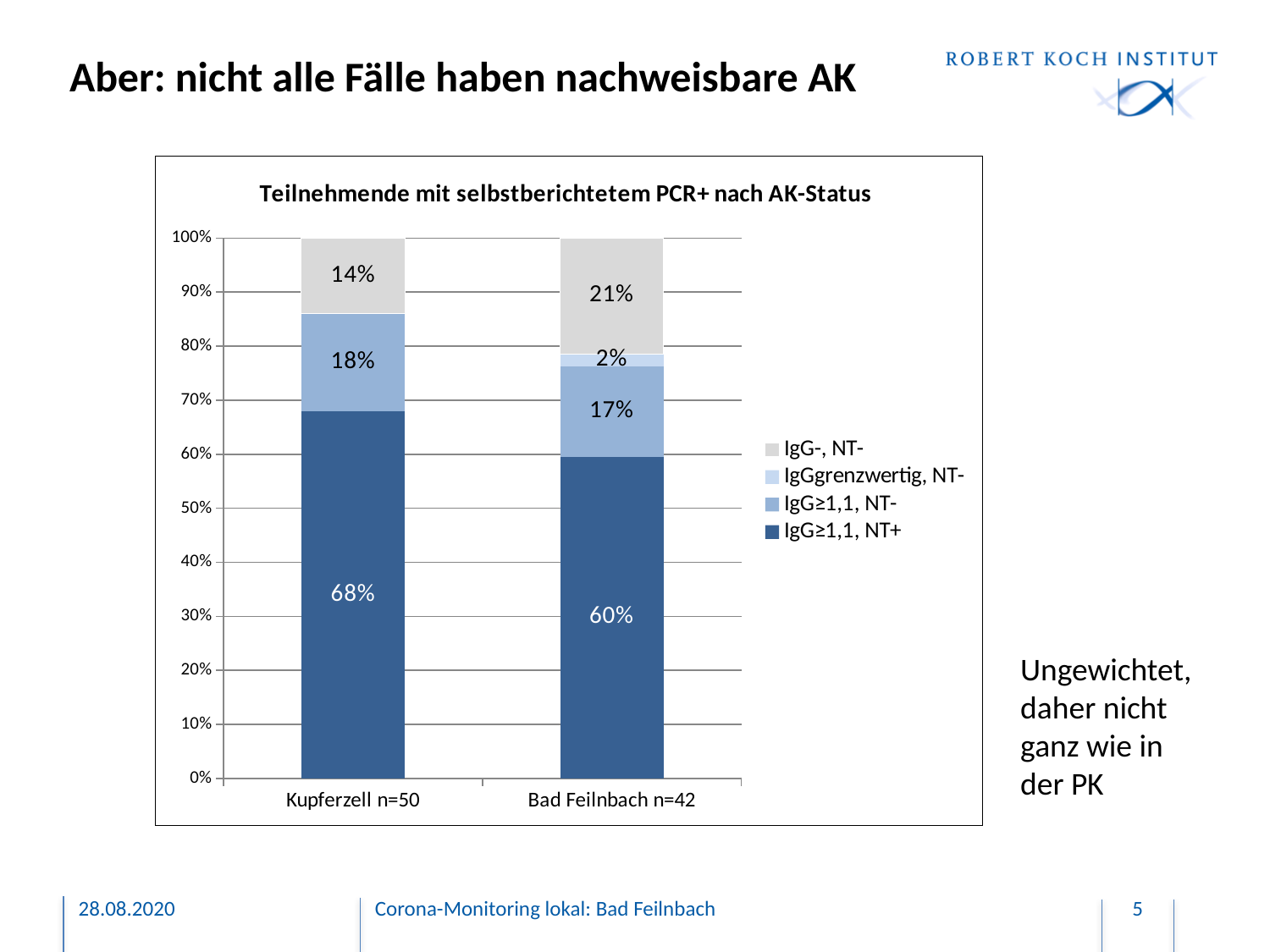
What is the value of IgG-, NT- for Bad Feilnbach n=42? 21% What kind of chart is shown on the slide? stacked bar chart Which category has the higher value for IgG≥1,1, NT+, Kupferzell n=50 or Bad Feilnbach n=42? Kupferzell n=50 How many categories are shown on the x axis? 2 What is the value of IgG≥1,1, NT- for Kupferzell n=50? 18% What is the difference between the IgG-, NT- values for Bad Feilnbach n=42 and Kupferzell n=50? 7% What is the value of IgGgrenzwertig, NT- for Bad Feilnbach n=42? 2% How many series does the legend list? 4 Which segment is the largest in the Bad Feilnbach n=42 bar? IgG≥1,1, NT+ What is the value of IgG≥1,1, NT+ for Bad Feilnbach n=42? 60% What is the title of the chart? Teilnehmende mit selbstberichtetem PCR+ nach AK-Status What is the value of IgG≥1,1, NT+ for Kupferzell n=50? 68%